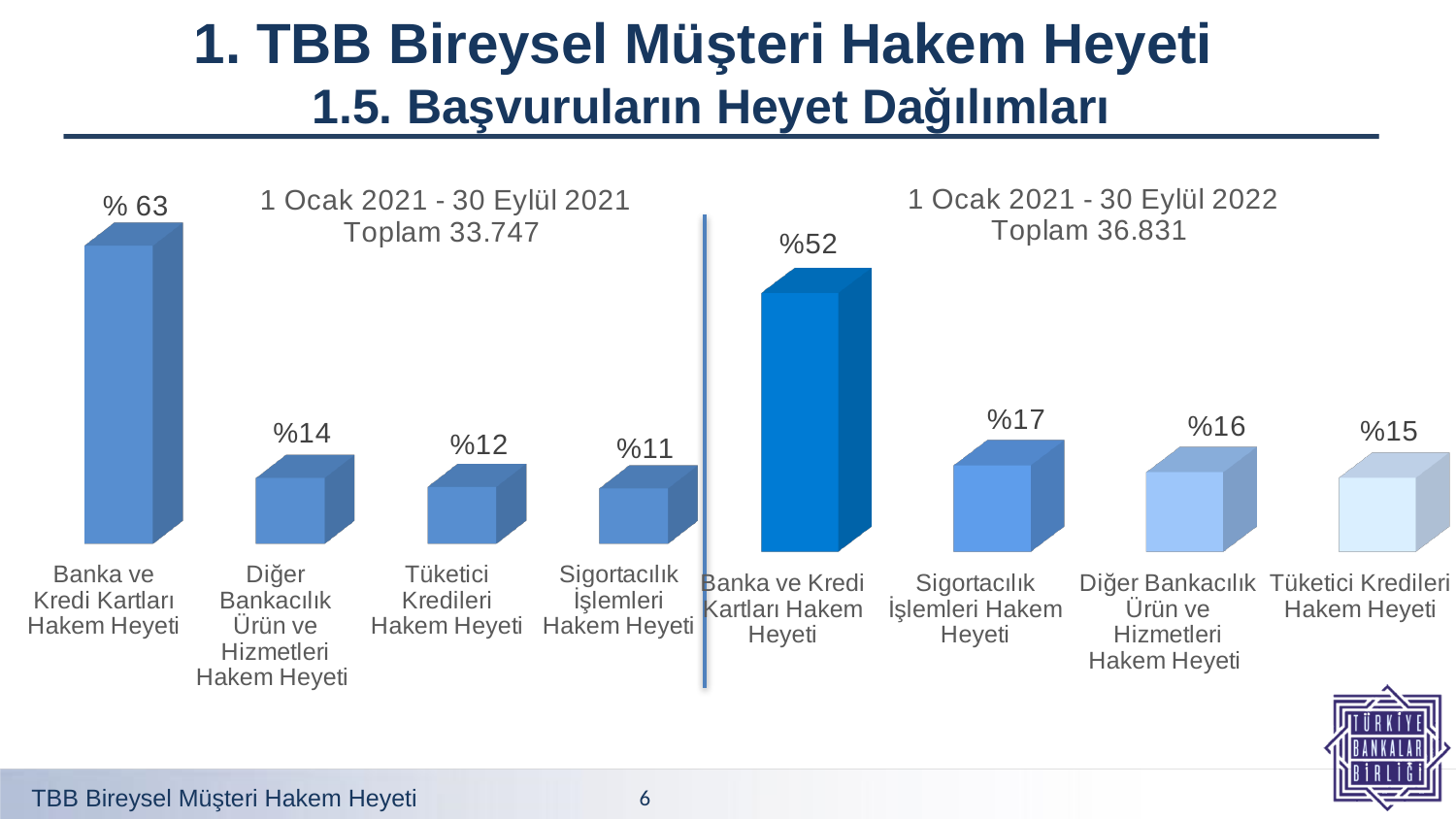
In the right chart (1 Ocak 2021 - 30 Eylül 2022), which category has the highest value? Banka ve Kredi Kartları Hakem Heyeti In the right chart (1 Ocak 2021 - 30 Eylül 2022), what is the value for Diğer Bankacılık Ürün ve Hizmetleri Hakem Heyeti? %16 In the left chart (1 Ocak 2021 - 30 Eylül 2021), what is the value for Sigortacılık İşlemleri Hakem Heyeti? %11 In the right chart (1 Ocak 2021 - 30 Eylül 2022), what is the difference between Sigortacılık İşlemleri Hakem Heyeti and Tüketici Kredileri Hakem Heyeti? 2 percentage points What kind of chart is the right chart (1 Ocak 2021 - 30 Eylül 2022)? Bar chart In the left chart (1 Ocak 2021 - 30 Eylül 2021), which category has the lowest value? Sigortacılık İşlemleri Hakem Heyeti In the left chart (1 Ocak 2021 - 30 Eylül 2021), what is the value for Banka ve Kredi Kartları Hakem Heyeti? % 63 What total (Toplam) is shown for the right chart (1 Ocak 2021 - 30 Eylül 2022)? 36.831 In the right chart (1 Ocak 2021 - 30 Eylül 2022), what is the value for Tüketici Kredileri Hakem Heyeti? %15 In the right chart (1 Ocak 2021 - 30 Eylül 2022), which is larger: Sigortacılık İşlemleri Hakem Heyeti or Diğer Bankacılık Ürün ve Hizmetleri Hakem Heyeti? Sigortacılık İşlemleri Hakem Heyeti In the left chart (1 Ocak 2021 - 30 Eylül 2021), what is the difference between Banka ve Kredi Kartları Hakem Heyeti and Diğer Bankacılık Ürün ve Hizmetleri Hakem Heyeti? 49 percentage points How many categories does the left chart (1 Ocak 2021 - 30 Eylül 2021) show? 4